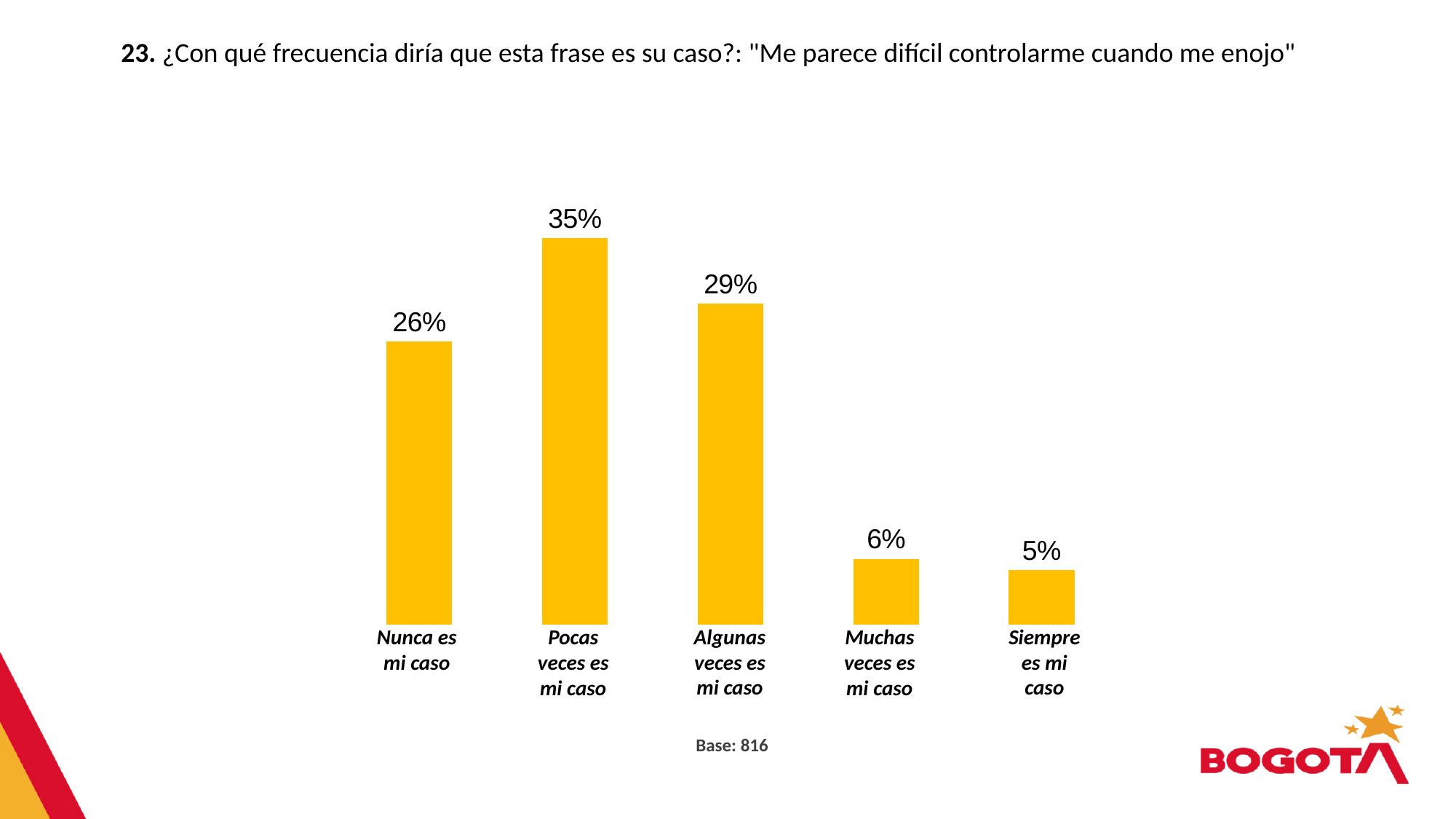
What is the base (sample size) shown below the chart? 816 What is the difference between "Nunca es mi caso" and "Siempre es mi caso"? 21% What is the value for "Nunca es mi caso"? 26% What kind of chart is shown on the slide? Bar chart What is the difference between "Pocas veces es mi caso" and "Algunas veces es mi caso"? 6% Which category has the lowest value? Siempre es mi caso What is the value for "Muchas veces es mi caso"? 6% What is the value for "Pocas veces es mi caso"? 35% What is the value for "Siempre es mi caso"? 5% Which is larger, "Nunca es mi caso" or "Algunas veces es mi caso"? Algunas veces es mi caso Which category has the highest value? Pocas veces es mi caso How many categories are shown in the chart? 5